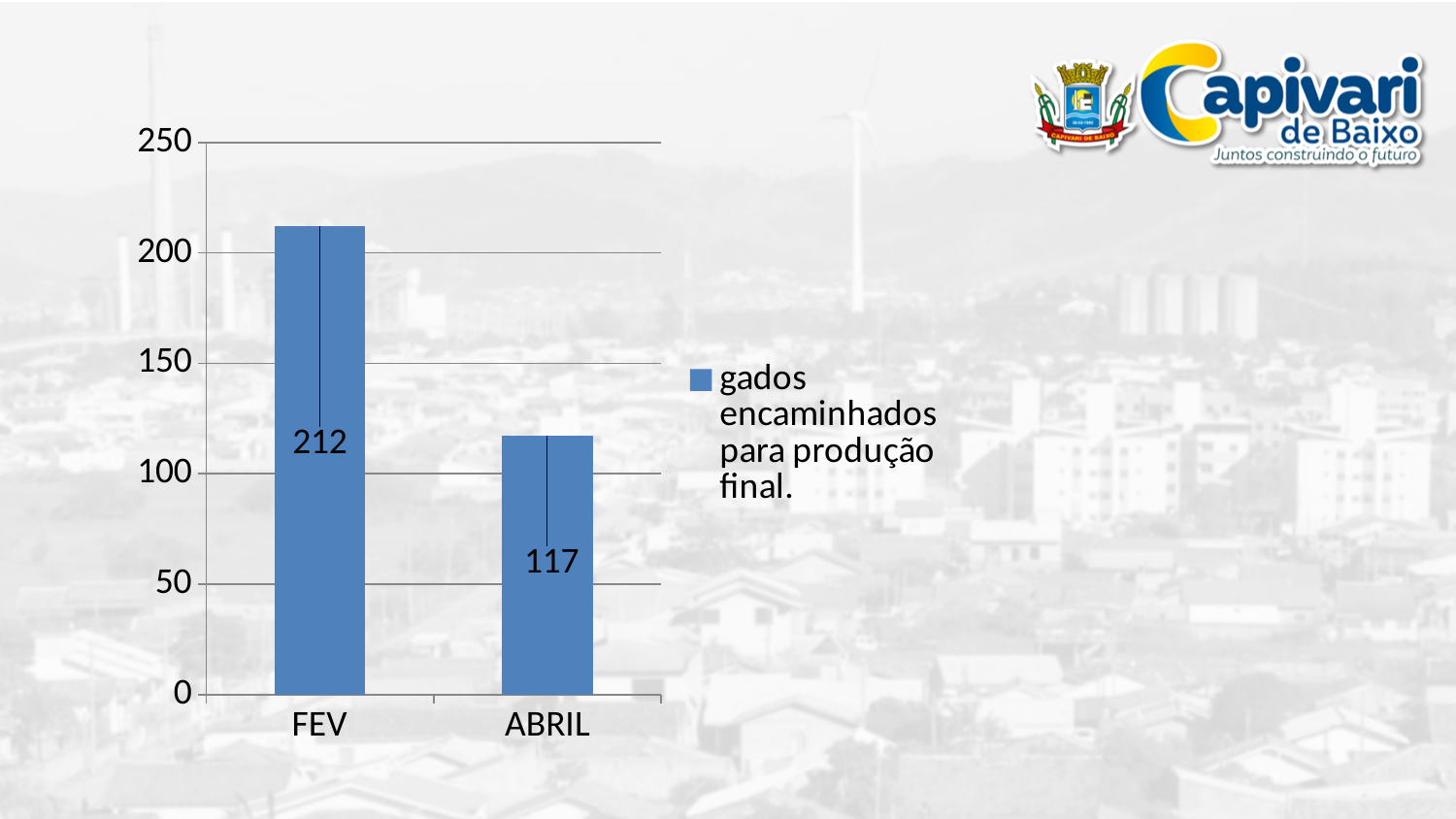
Which is larger, the value for FEV or the value for ABRIL? FEV What is the difference between the values for FEV and ABRIL? 95 How many series does the legend list? 1 Is the value for FEV greater or less than 200? greater What kind of chart is shown on the slide? bar chart What is the value for FEV? 212 Is the value for ABRIL greater or less than 150? less Which category has the lowest value? ABRIL What is the legend entry for the series shown? gados encaminhados para produção final. What is the value for ABRIL? 117 How many categories are shown on the x axis? 2 Which category has the highest value? FEV